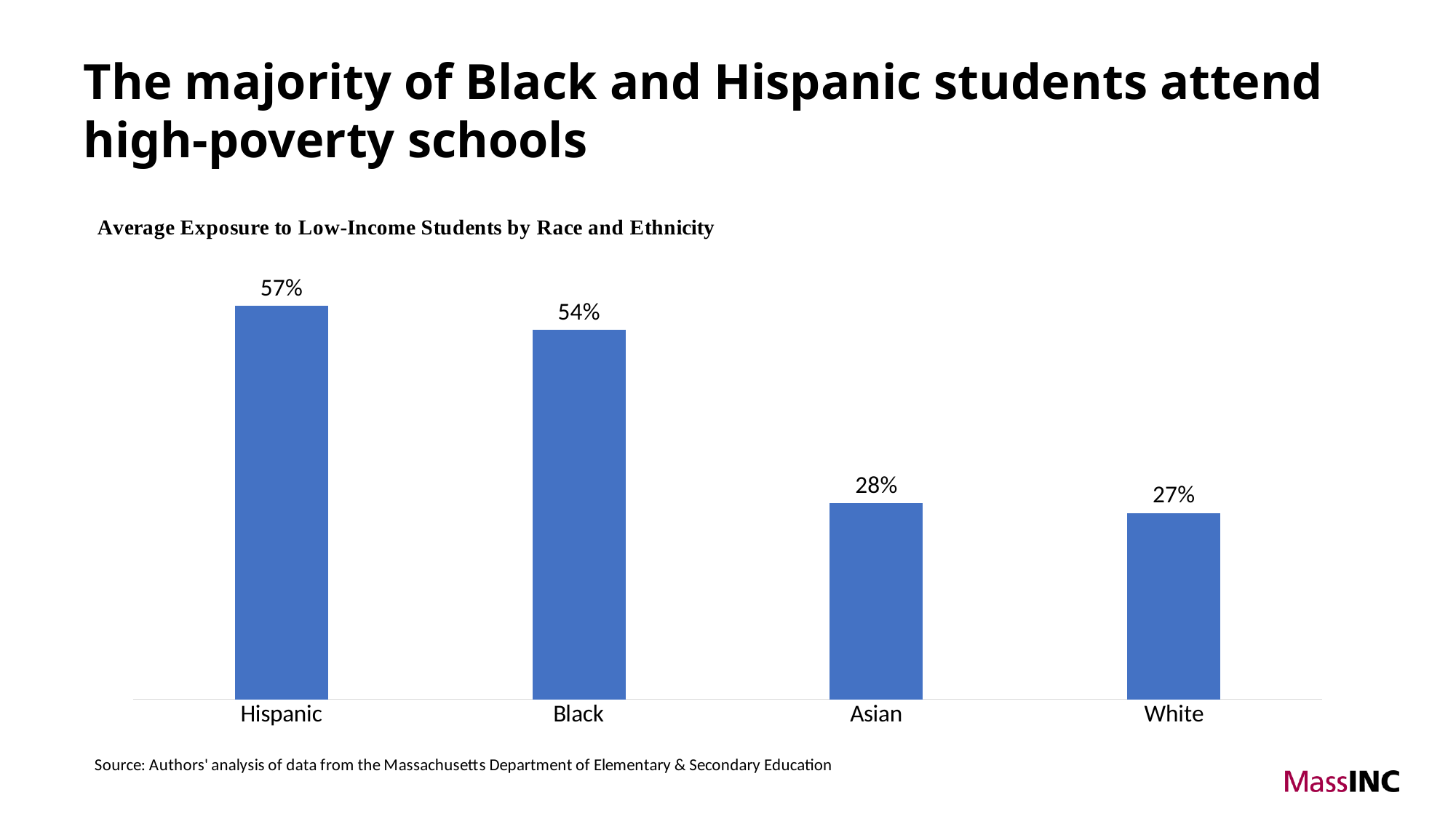
What is the difference in average exposure between Hispanic and White students? 30 percentage points How many racial/ethnic groups are shown in the chart? 4 What is the average exposure to low-income students for Hispanic students? 57% Which group has the lowest average exposure to low-income students? White What is the difference in average exposure between Black and Asian students? 26 percentage points Which group has the highest average exposure to low-income students? Hispanic What is the average exposure to low-income students for White students? 27% What is the average exposure to low-income students for Black students? 54% Which group has a higher average exposure to low-income students, Black or Asian? Black What is the title of the chart? Average Exposure to Low-Income Students by Race and Ethnicity What is the average exposure to low-income students for Asian students? 28% What type of chart is shown on the slide? Bar chart